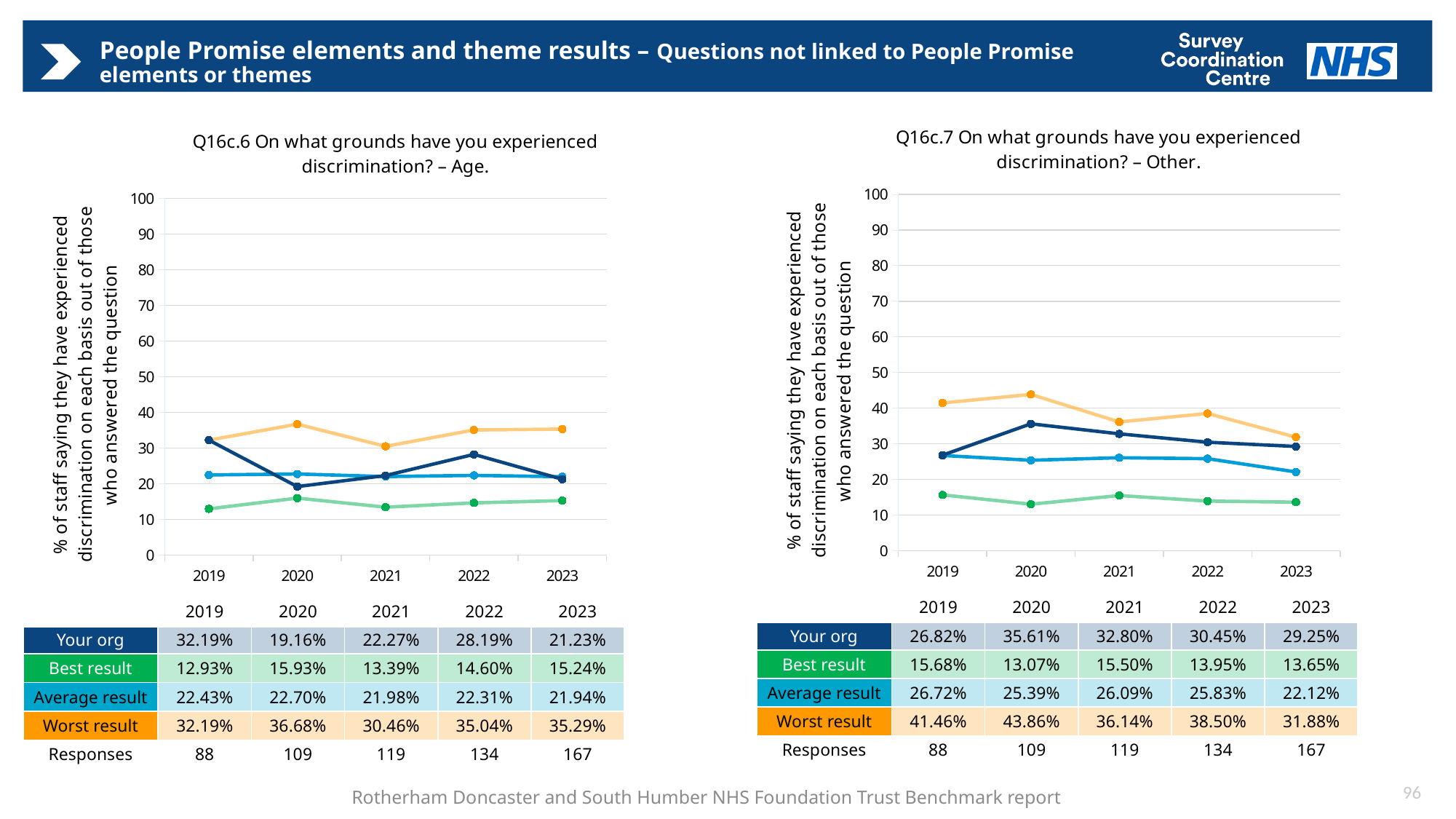
In the Q16c.6 Age chart, in which year is the Your org value highest? 2019 How many years are plotted on the x axis of the Q16c.6 Age chart? 5 What kind of chart is the Q16c.7 Other chart? line chart In the Q16c.6 Age chart, which is larger for 2020: the Your org value or the Average result value? Average result In the Q16c.7 Other chart, is the Worst result value for 2020 greater or less than 40? greater In the Q16c.7 Other chart, what is the difference between the Worst result and Best result values for 2020? 30.79 percentage points In the Q16c.7 Other chart, does the Your org value rise or fall from 2020 to 2023? fall In the Q16c.7 Other chart, what is the Worst result value for 2020? 43.86% In the Q16c.6 Age chart, what is the Your org value for 2019? 32.19% In the Q16c.6 Age chart, what is the difference between the Your org values for 2019 and 2023? 10.96 percentage points In the Q16c.7 Other chart, in which year is the Your org value lowest? 2019 In the Q16c.7 Other chart, what is the Average result value for 2023? 22.12%